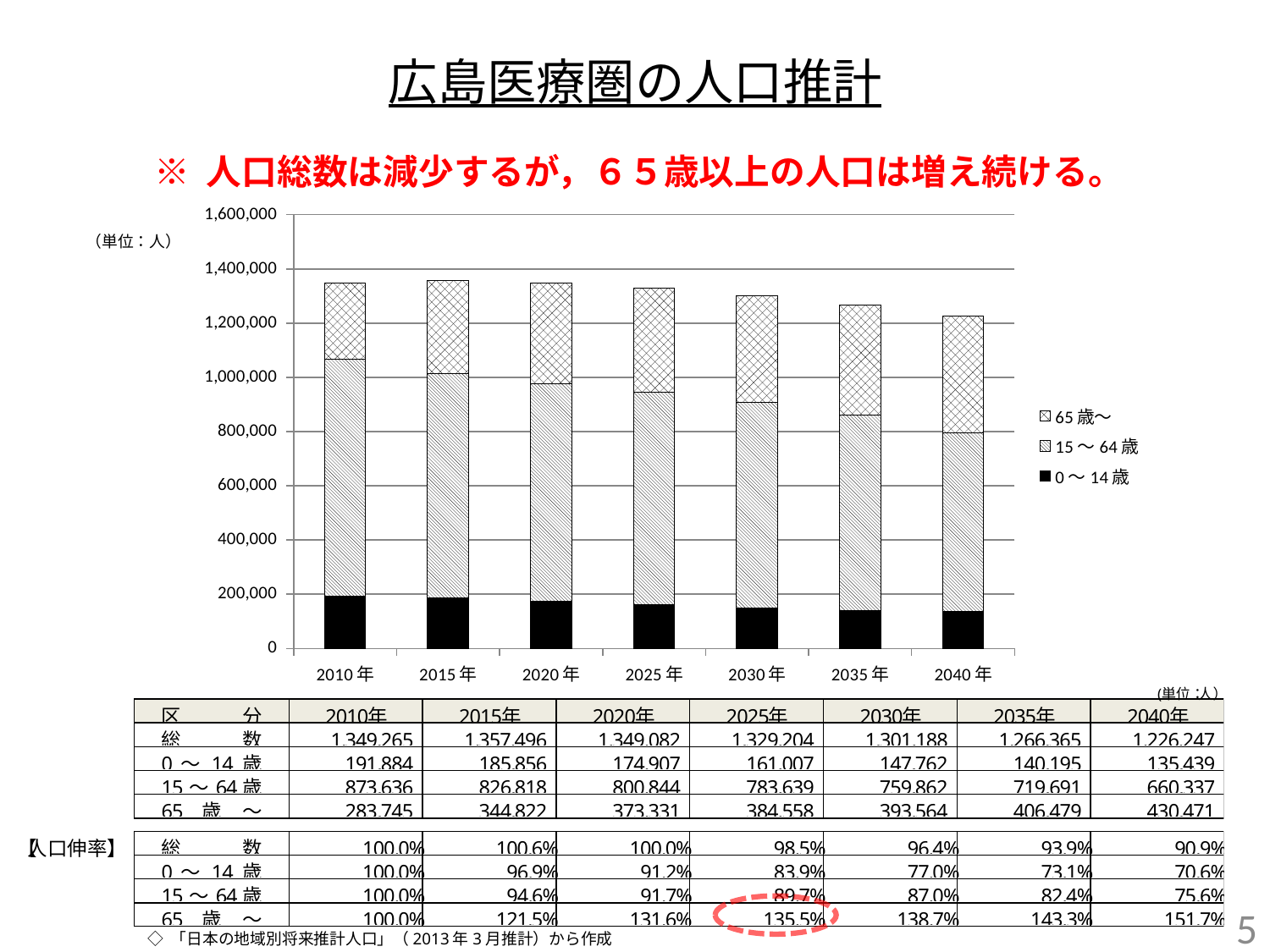
According to the table below the chart, what is the total population (総数) in 2010? 1,349,265 How many years (categories) are plotted along the x axis of the chart? 7 According to the table below the chart, what is the 65歳～ population in 2040? 430,471 Which age group is shown in solid black at the bottom of each bar? 0～14歳 What is the title of the slide containing the chart? 広島医療圏の人口推計 Is the total population bar for 2040 greater or less than 1,200,000? greater Does the 65歳～ segment rise or fall from 2010 to 2040? rise Using the table values, by how much does the 65歳～ population in 2040 exceed that in 2010? 146,726 Does the total height of the bars rise or fall from 2015 to 2040? fall How many series does the chart legend list? 3 Is the 0～14歳 segment for 2010 greater or less than 200,000? less What kind of chart is shown on the slide? stacked bar chart